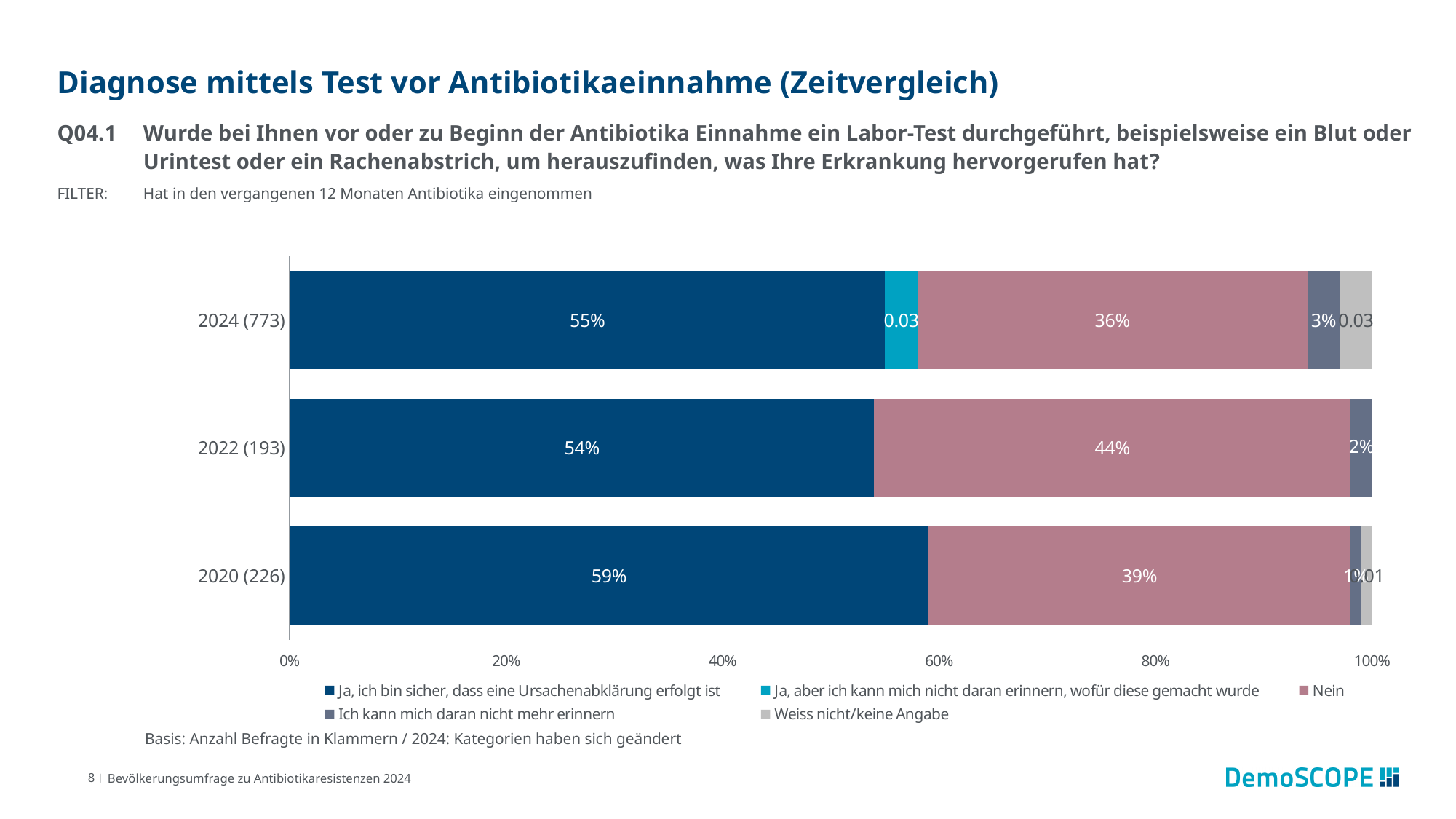
How many series does the legend list? 5 What is the value for "Ich kann mich daran nicht mehr erinnern" in 2024 (773)? 3% What is the value for "Ja, ich bin sicher, dass eine Ursachenabklärung erfolgt ist" in 2024 (773)? 55% Which year has the highest value for "Ja, ich bin sicher, dass eine Ursachenabklärung erfolgt ist"? 2020 (226) What is the value for "Nein" in 2022 (193)? 44% Which is larger: the "Ja, ich bin sicher" value for 2022 (193) or for 2020 (226)? 2020 (226) How many years (bars) are shown in the chart? 3 What is the difference between the "Nein" values for 2022 (193) and 2024 (773)? 8 percentage points What is the value for "Ja, ich bin sicher, dass eine Ursachenabklärung erfolgt ist" in 2020 (226)? 59% What kind of chart is shown on the slide? Stacked bar chart Which year has the lowest value for "Nein"? 2024 (773) Which legend entry is shown in the dark blue colour? Ja, ich bin sicher, dass eine Ursachenabklärung erfolgt ist